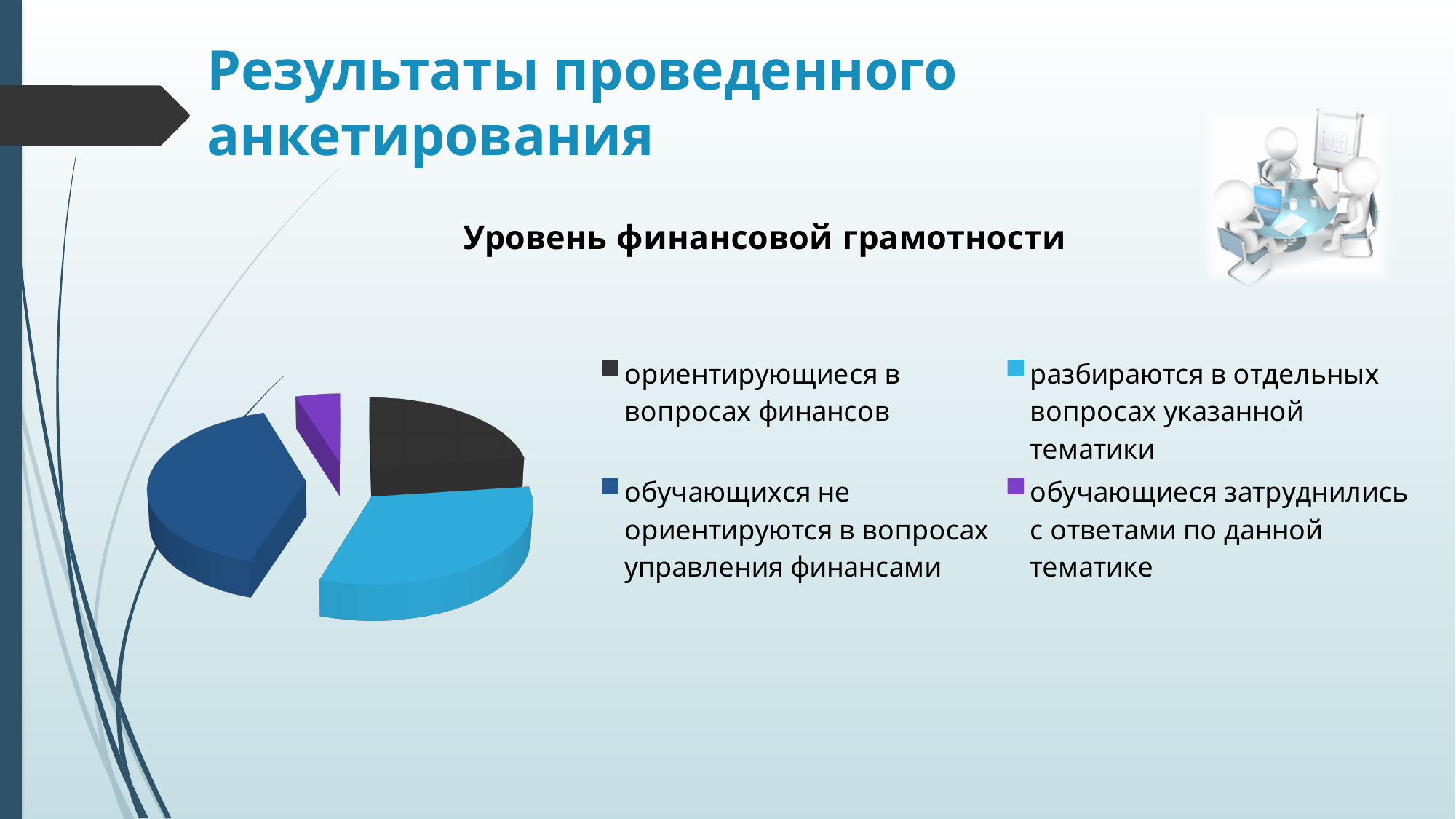
What kind of chart is shown on the slide? pie chart Which category has the smallest slice of the pie? обучающиеся затруднились с ответами по данной тематике What colour is the slice for "обучающиеся затруднились с ответами по данной тематике"? purple How many entries does the chart legend list? 4 How many slices does the pie chart have? 4 Which slice is larger: "обучающихся не ориентируются в вопросах управления финансами" or "обучающиеся затруднились с ответами по данной тематике"? обучающихся не ориентируются в вопросах управления финансами What is the title of the chart? Уровень финансовой грамотности Which slice is larger: "ориентирующиеся в вопросах финансов" or "обучающиеся затруднились с ответами по данной тематике"? ориентирующиеся в вопросах финансов Which slice is larger: "разбираются в отдельных вопросах указанной тематики" or "обучающиеся затруднились с ответами по данной тематике"? разбираются в отдельных вопросах указанной тематики